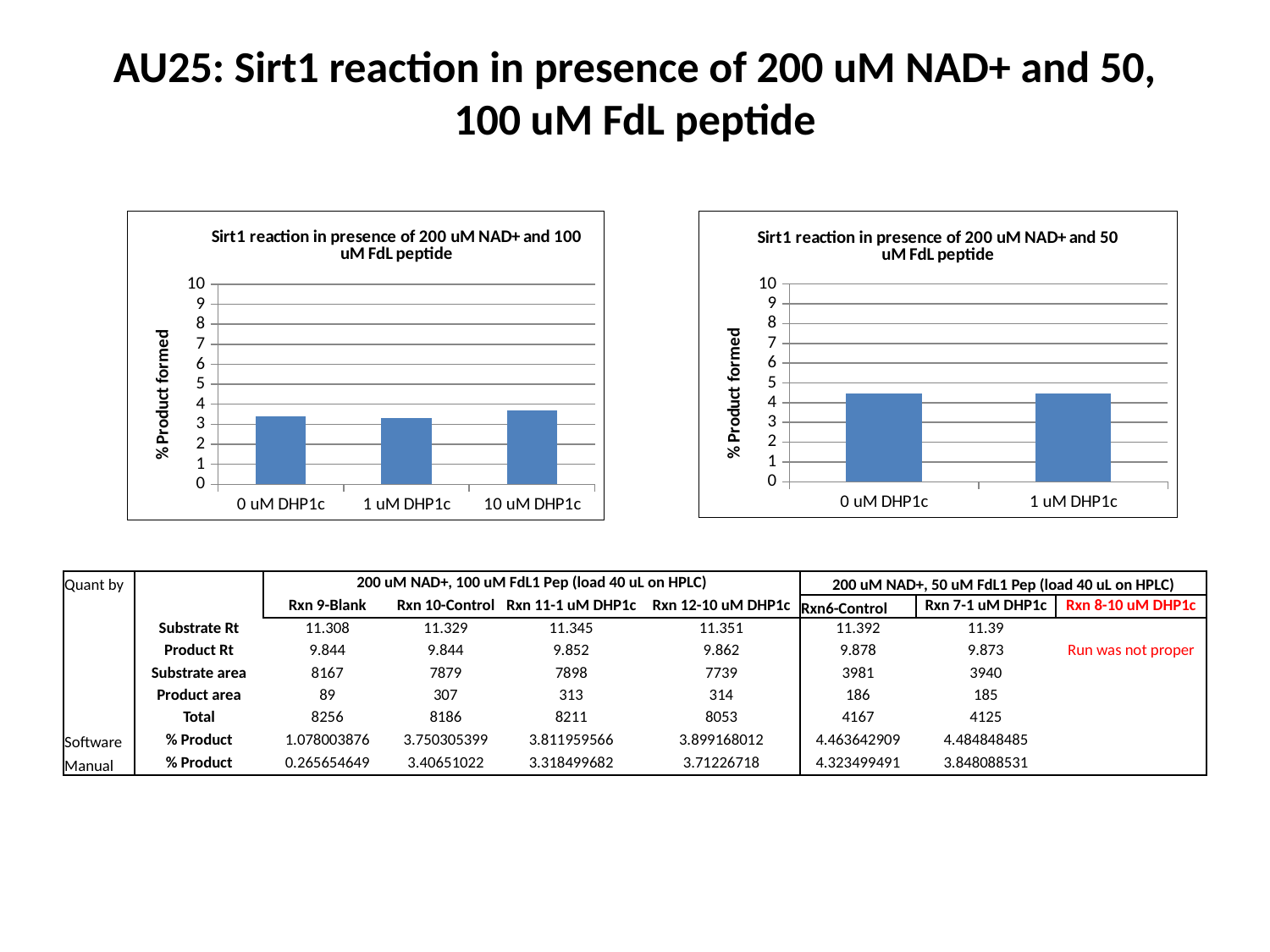
What type of chart is the left chart titled 'Sirt1 reaction in presence of 200 uM NAD+ and 100 uM FdL peptide'? bar chart In the left chart (100 uM FdL peptide), is the value for 10 uM DHP1c greater or less than 4? less In the left chart (100 uM FdL peptide), is the value for 1 uM DHP1c greater or less than 4? less In the left chart (100 uM FdL peptide), which is larger: the value for 10 uM DHP1c or the value for 1 uM DHP1c? 10 uM DHP1c In the left chart (100 uM FdL peptide), is the value for 0 uM DHP1c greater or less than 3? greater In the left chart (100 uM FdL peptide), which category has the highest % Product formed? 10 uM DHP1c What is the y-axis label of the right chart (50 uM FdL peptide)? % Product formed How many categories are shown on the x axis of the right chart (50 uM FdL peptide)? 2 What is the maximum value shown on the y axis of the left chart (100 uM FdL peptide)? 10 How many categories are shown on the x axis of the left chart (100 uM FdL peptide)? 3